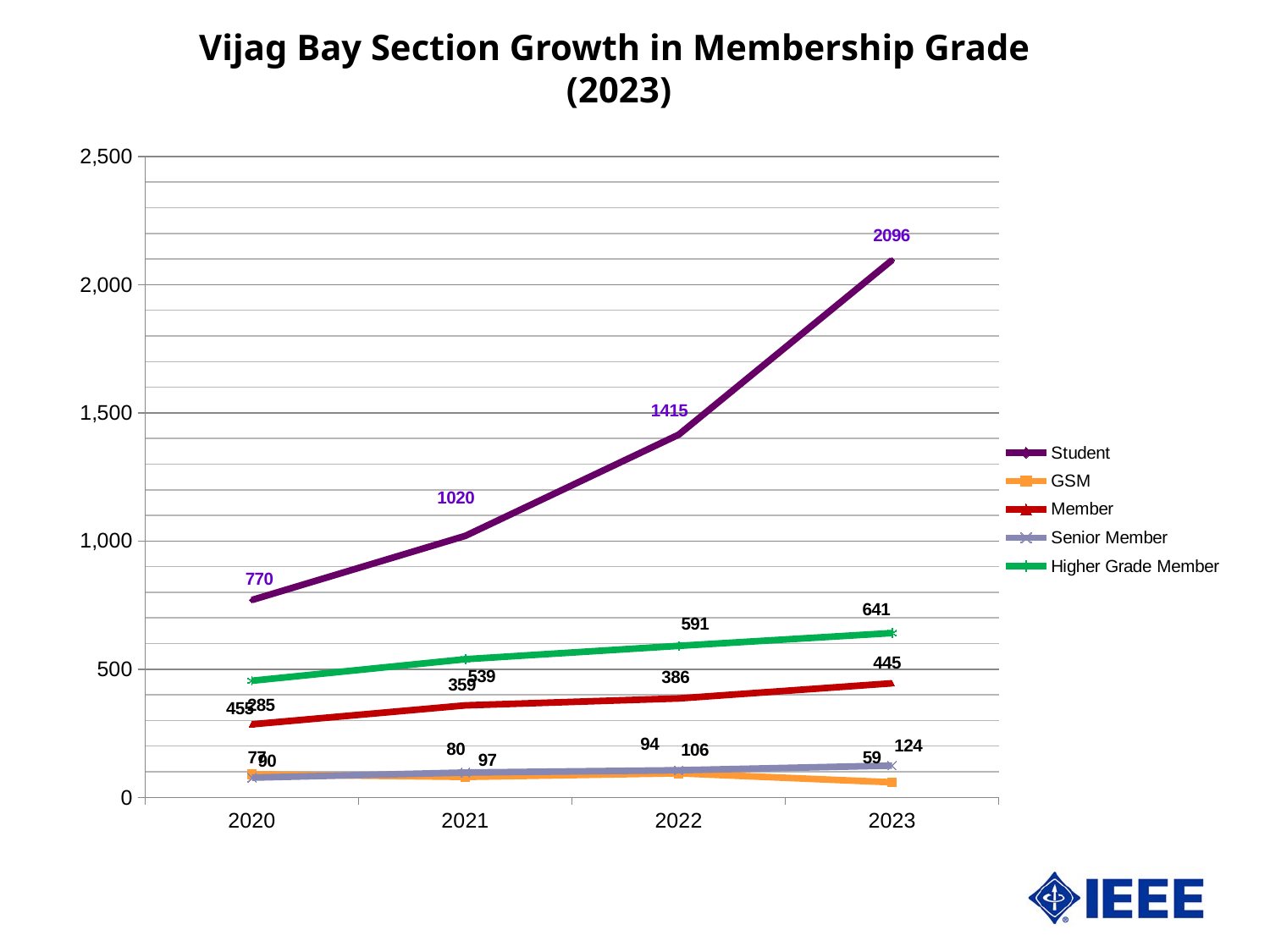
Does the Student series rise or fall from 2020 to 2023? rise What is the value for GSM in 2023? 59 In 2023, which is larger: Member or Higher Grade Member? Higher Grade Member What is the value for Member in 2022? 386 What is the value for Student in 2021? 1020 What kind of chart is shown on the slide? line chart Which membership grade has the lowest value in 2023? GSM How many series does the legend list? 5 What is the value for Student in 2023? 2096 Which membership grade has the highest value in 2023? Student What is the value for Higher Grade Member in 2023? 641 By how much did the Student value increase from 2022 to 2023? 681